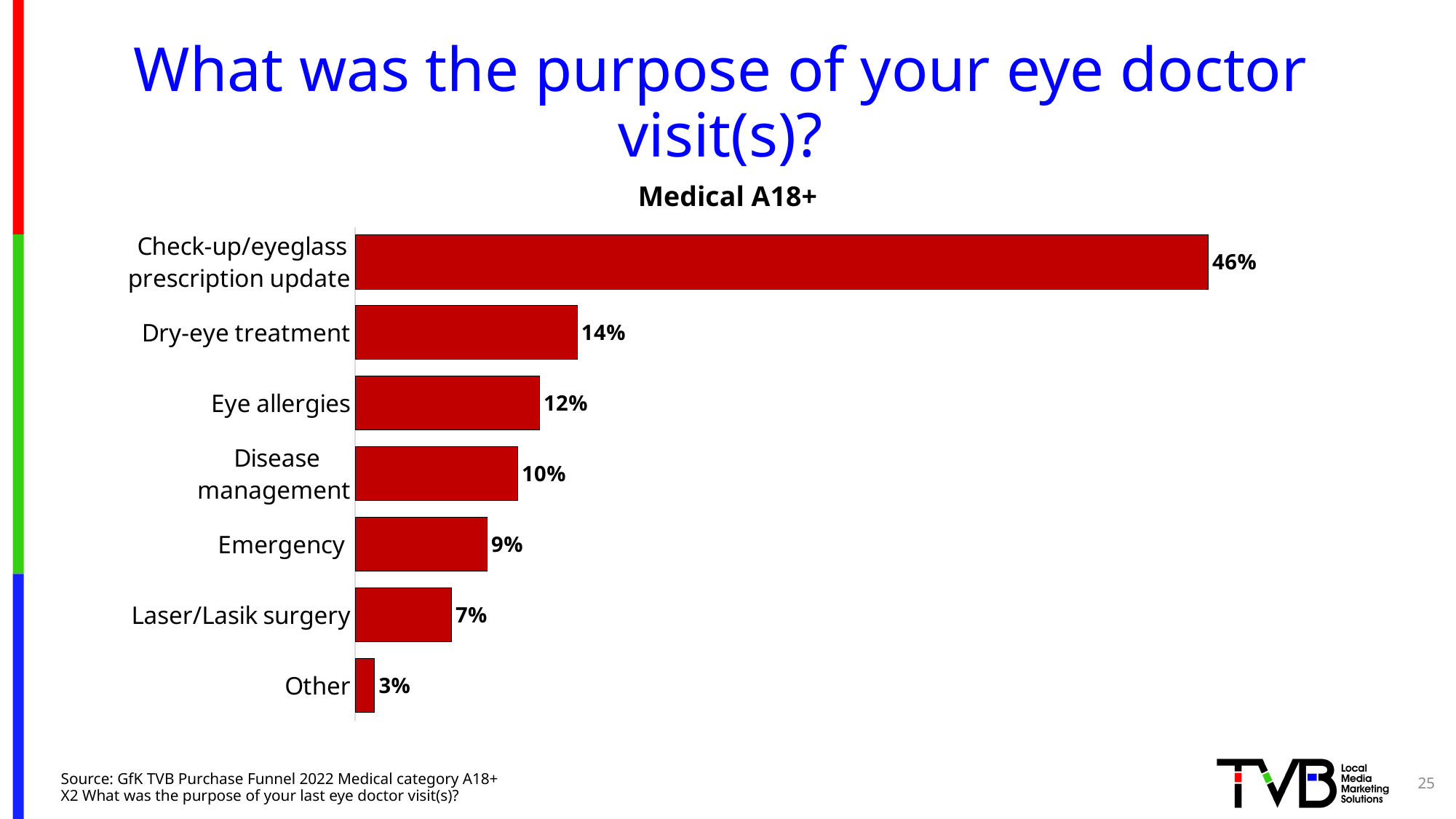
Which purpose of visit has the highest percentage? Check-up/eyeglass prescription update What is the value for Dry-eye treatment? 14% What kind of chart is shown on the slide? Bar chart What is the difference in percentage points between Eye allergies and Emergency? 3 What percentage of respondents visited the eye doctor for a check-up/eyeglass prescription update? 46% What is the title shown above the chart? Medical A18+ What colour are the bars in the chart? Red What is the value for Laser/Lasik surgery? 7% What is the difference in percentage points between Check-up/eyeglass prescription update and Dry-eye treatment? 32 How many purpose categories are shown in the chart? 7 Which purpose of visit has the lowest percentage? Other Which is larger, the value for Disease management or the value for Laser/Lasik surgery? Disease management